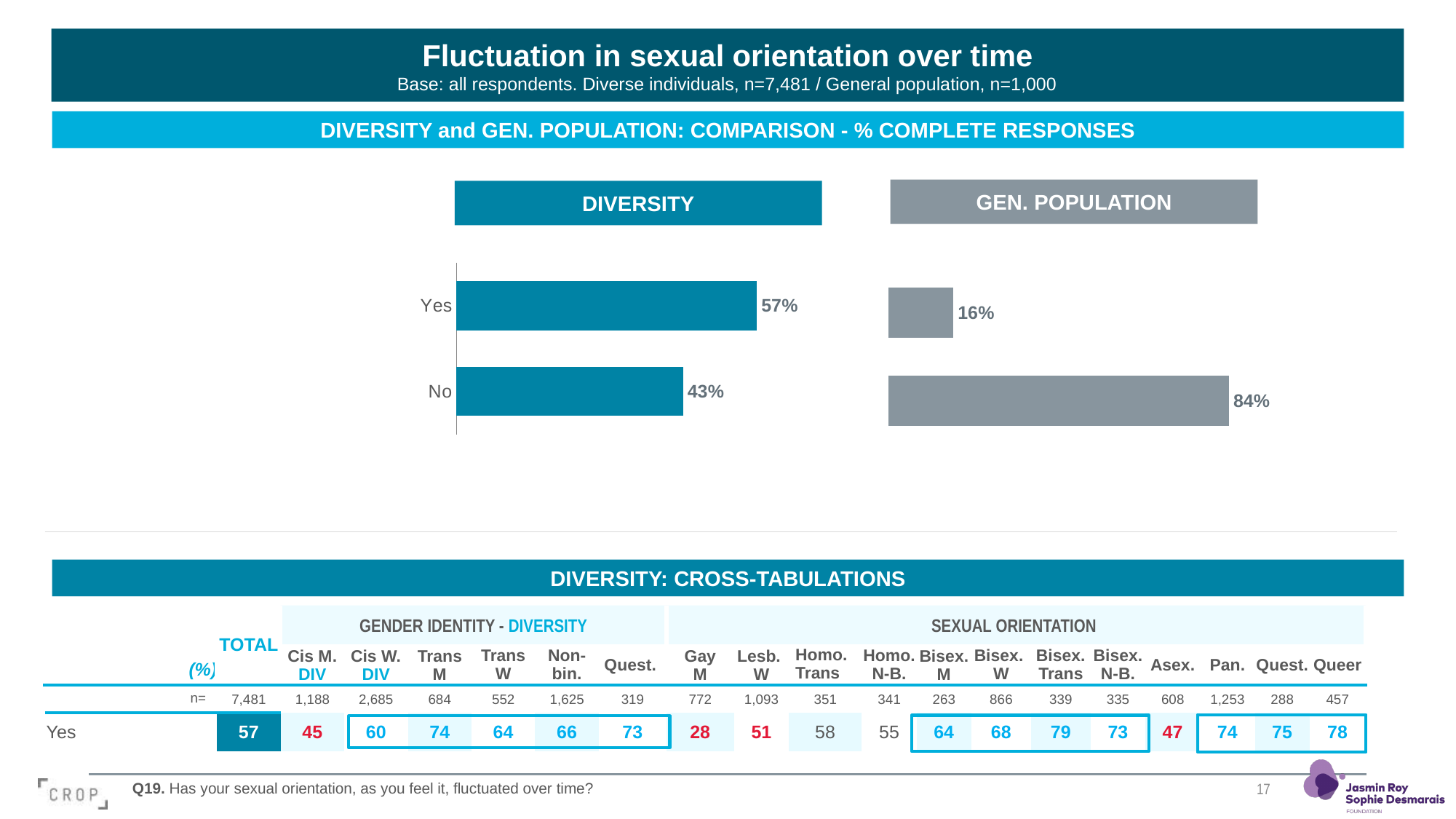
In the DIVERSITY chart, what percentage of respondents answered Yes? 57% In the DIVERSITY chart, which response has the higher percentage, Yes or No? Yes In the GEN. POPULATION chart, which response has the lower percentage? Yes In the DIVERSITY chart, what percentage of respondents answered No? 43% In the GEN. POPULATION chart, what percentage of respondents answered Yes? 16% What is the difference in percentage points between No and Yes in the GEN. POPULATION chart? 68 What colour are the bars in the GEN. POPULATION chart? Grey What type of chart is used to show the DIVERSITY and GEN. POPULATION comparison? Bar chart How many response categories are shown in the DIVERSITY chart? 2 Is the Yes value in the DIVERSITY chart larger or smaller than the Yes value in the GEN. POPULATION chart? larger In the GEN. POPULATION chart, what percentage of respondents answered No? 84% What is the difference in percentage points between Yes and No in the DIVERSITY chart? 14